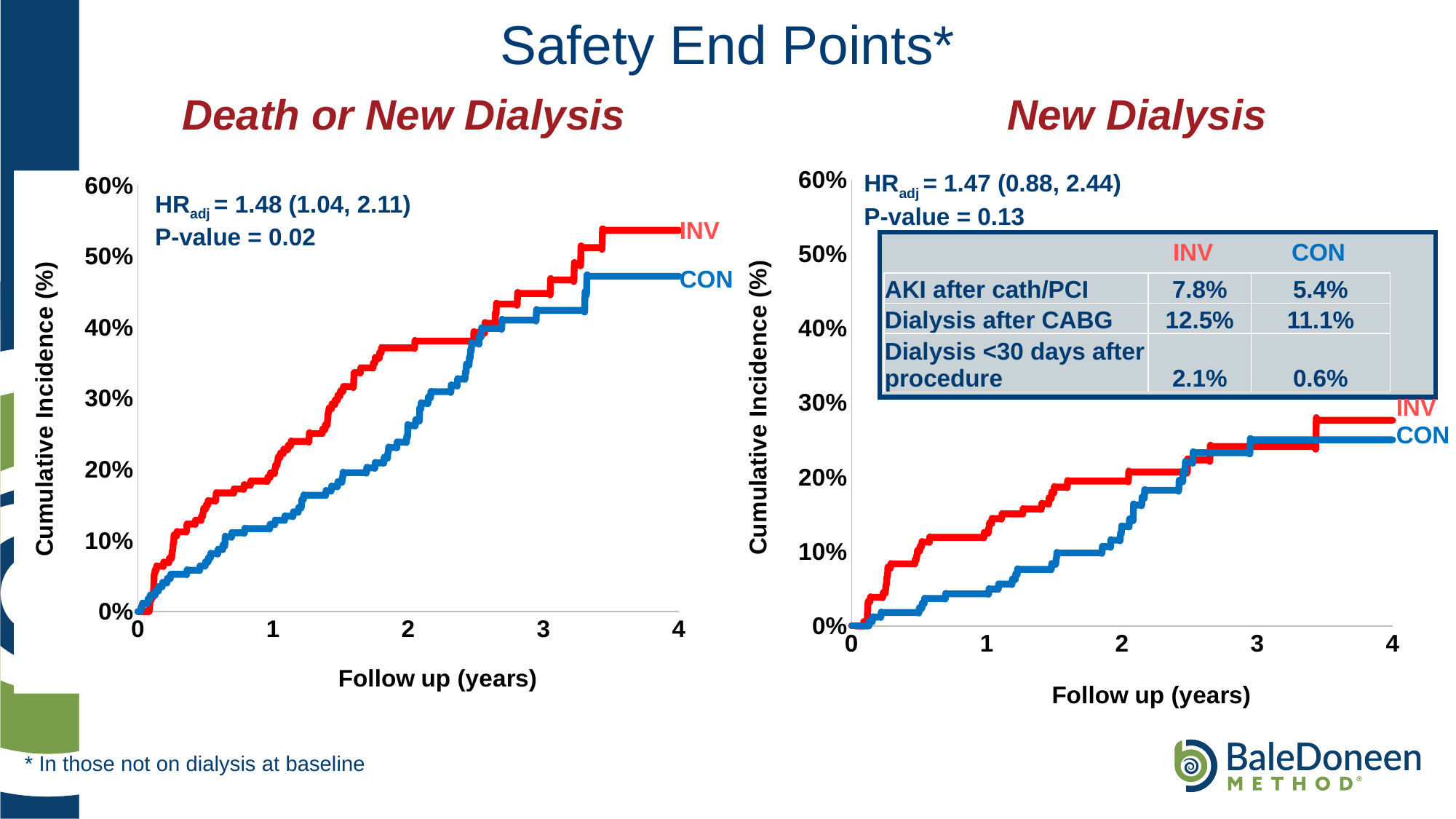
In the 'Death or New Dialysis' chart, is the cumulative incidence for CON at 4 years greater or less than 50%? less In the 'New Dialysis' chart, is the cumulative incidence for INV at 4 years greater or less than 30%? less In the 'Death or New Dialysis' chart, which group has the higher cumulative incidence at 1 year of follow up, INV or CON? INV In the table on the 'New Dialysis' chart, what is the rate of AKI after cath/PCI for the INV group? 7.8% In the 'Death or New Dialysis' chart, is the cumulative incidence for INV at 4 years greater or less than 50%? greater In the 'Death or New Dialysis' chart, do the cumulative incidence curves rise or fall as follow-up time increases? rise What kind of chart is the 'Death or New Dialysis' chart? line chart In the 'New Dialysis' chart, which group has the higher cumulative incidence at 1 year of follow up, INV or CON? INV How many series are plotted in the 'Death or New Dialysis' chart? 2 In the table on the 'New Dialysis' chart, what is the rate of dialysis after CABG for the CON group? 11.1% What adjusted hazard ratio is shown on the 'Death or New Dialysis' chart? 1.48 (1.04, 2.11) What P-value is shown on the 'New Dialysis' chart? 0.13